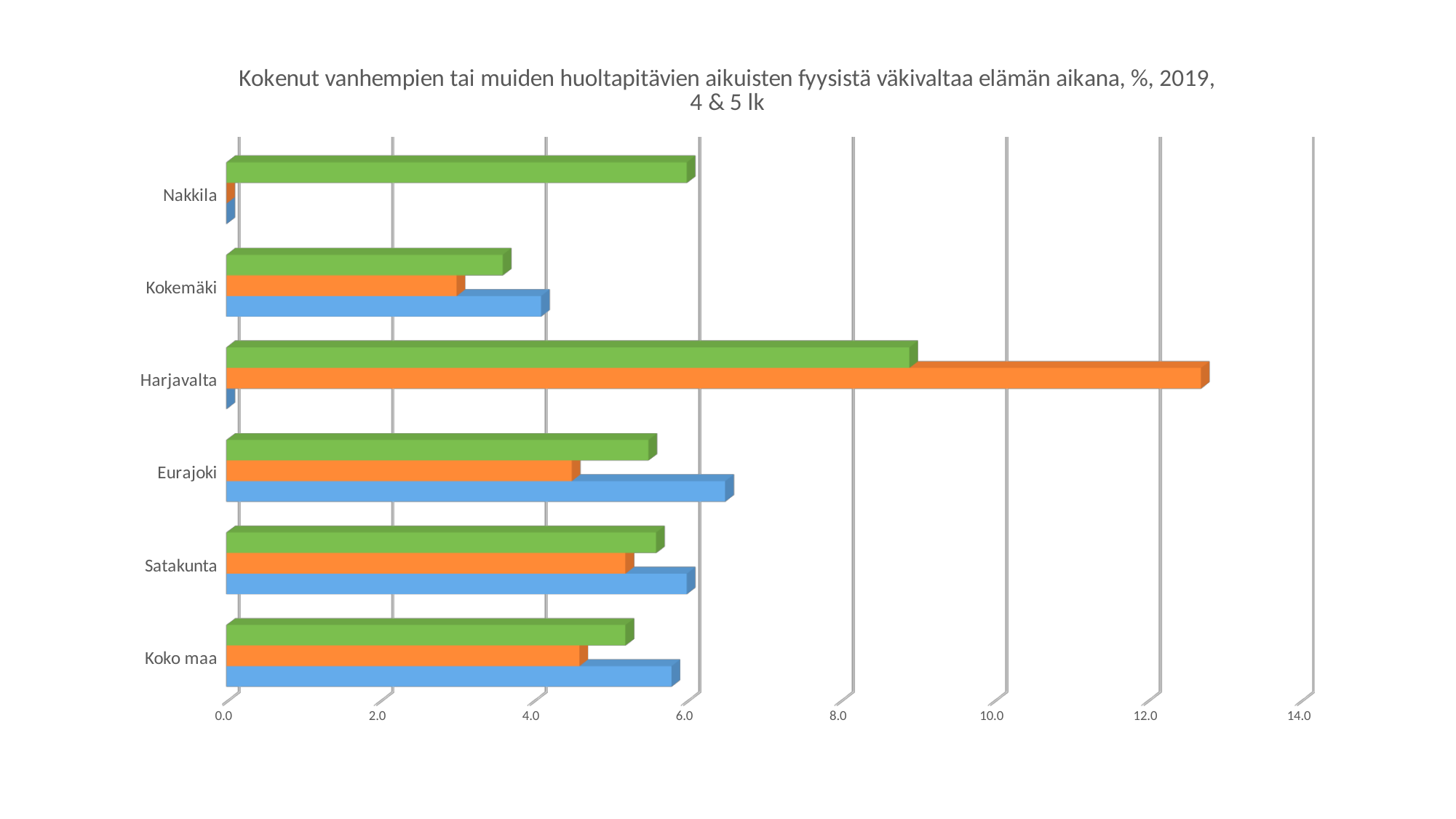
Is the value of the orange bar for Harjavalta greater or less than 12.0? greater How many bars are plotted for the category Kokemäki? 3 For Eurajoki, which bar is longer, the blue bar or the orange bar? blue Is the value of the green bar for Harjavalta greater or less than 8.0? greater Which category has the longest bar in the chart? Harjavalta Is the value of the blue bar for Eurajoki greater or less than 6.0? greater How many categories are shown on the vertical axis of the chart? 6 Which category has the shortest green bar? Kokemäki For Harjavalta, which bar is longer, the orange bar or the green bar? orange What kind of chart is shown on the slide? bar chart What is the highest value shown on the horizontal axis of the chart? 14.0